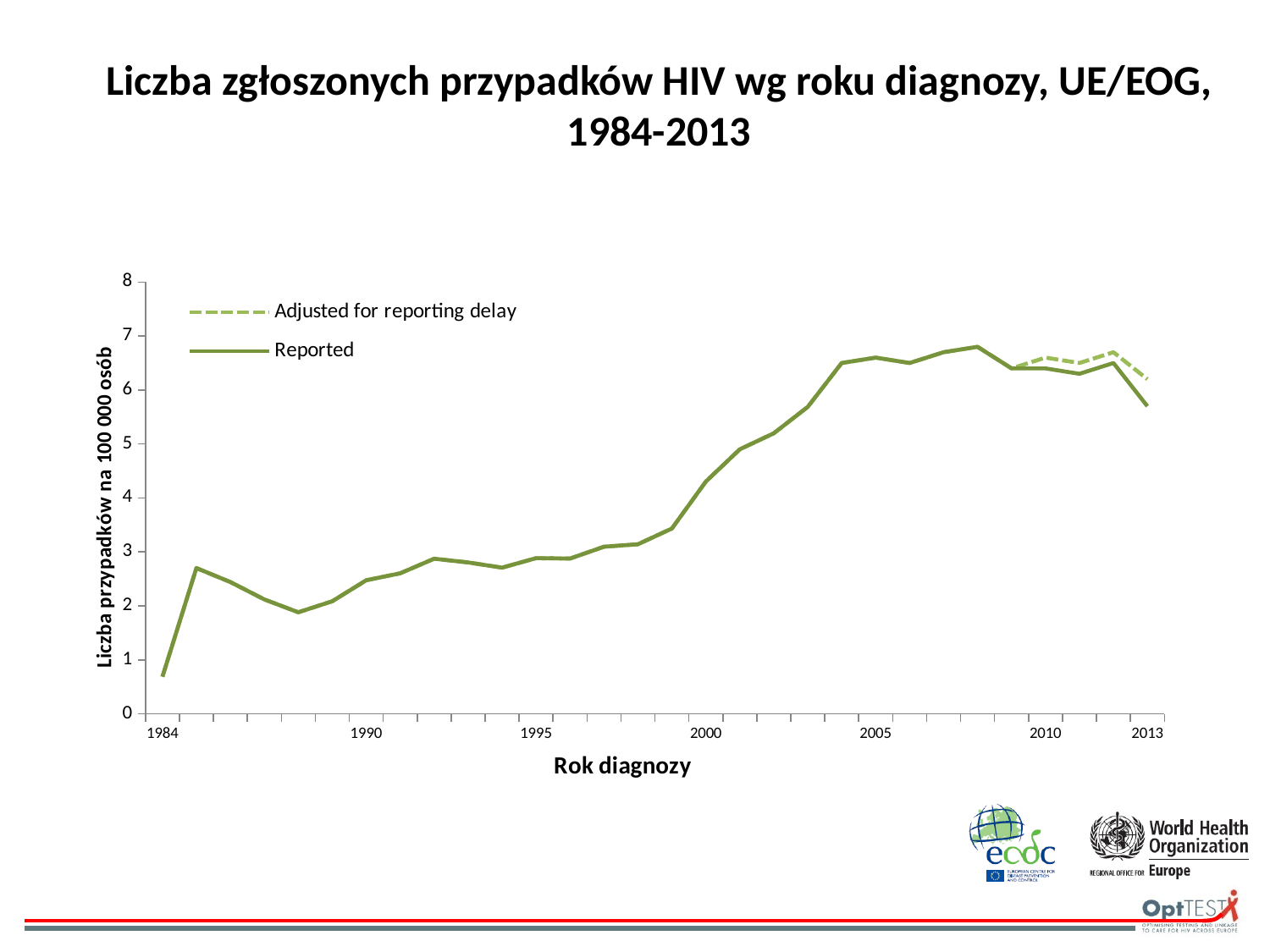
Is the Reported value for 1984 greater or less than 1? less Does the Reported series rise or fall between 1999 and 2004? rise Which is larger, the Reported value for 1990 or for 2000? 2000 Is the Reported value for 2000 greater or less than 4? greater Is the Reported value for 2005 greater or less than 6? greater What kind of chart is shown on the slide? line chart How many series does the legend list? 2 Which year has the lowest value for the Reported series? 1984 What are the two series named in the legend? Adjusted for reporting delay; Reported What is the label of the y axis? Liczba przypadków na 100 000 osób